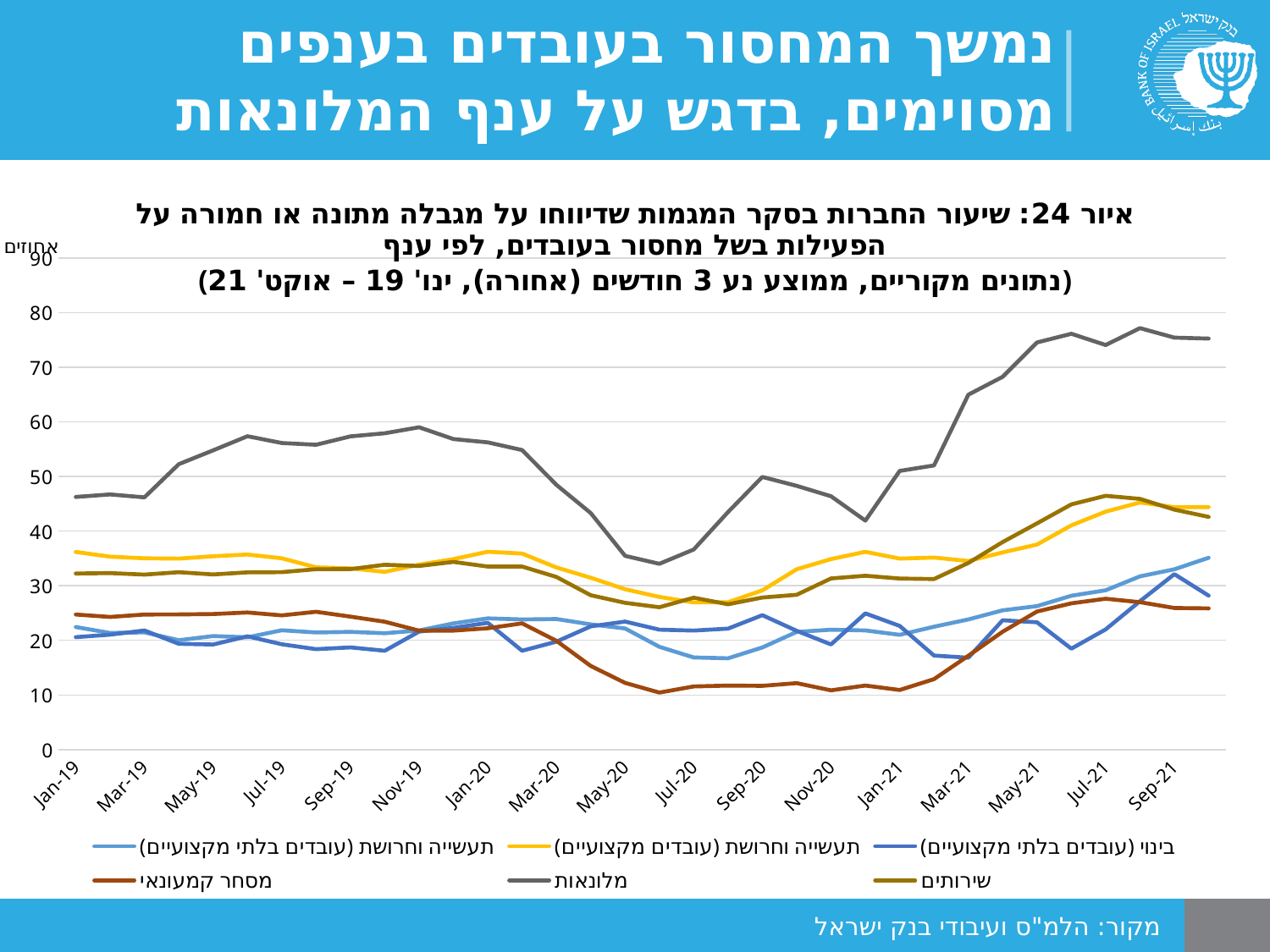
Which series has the lowest value at Jul-20? מסחר קמעונאי Is the value for מלונאות at Sep-21 greater or less than 70? greater What kind of chart is shown on the slide? line chart Does the value for מלונאות rise or fall between Jan-21 and Jul-21? rise Is the value for מלונאות at Jan-19 greater or less than 40? greater What is the highest value shown on the vertical axis? 90 Is the value for מסחר קמעונאי at Jul-20 greater or less than 20? less Which series has the highest value at Sep-21? מלונאות Does the value for מסחר קמעונאי rise or fall between Jan-20 and Jul-20? fall How many series does the legend list? 6 At Sep-21, which is larger: תעשייה וחרושת (עובדים מקצועיים) or מסחר קמעונאי? תעשייה וחרושת (עובדים מקצועיים)